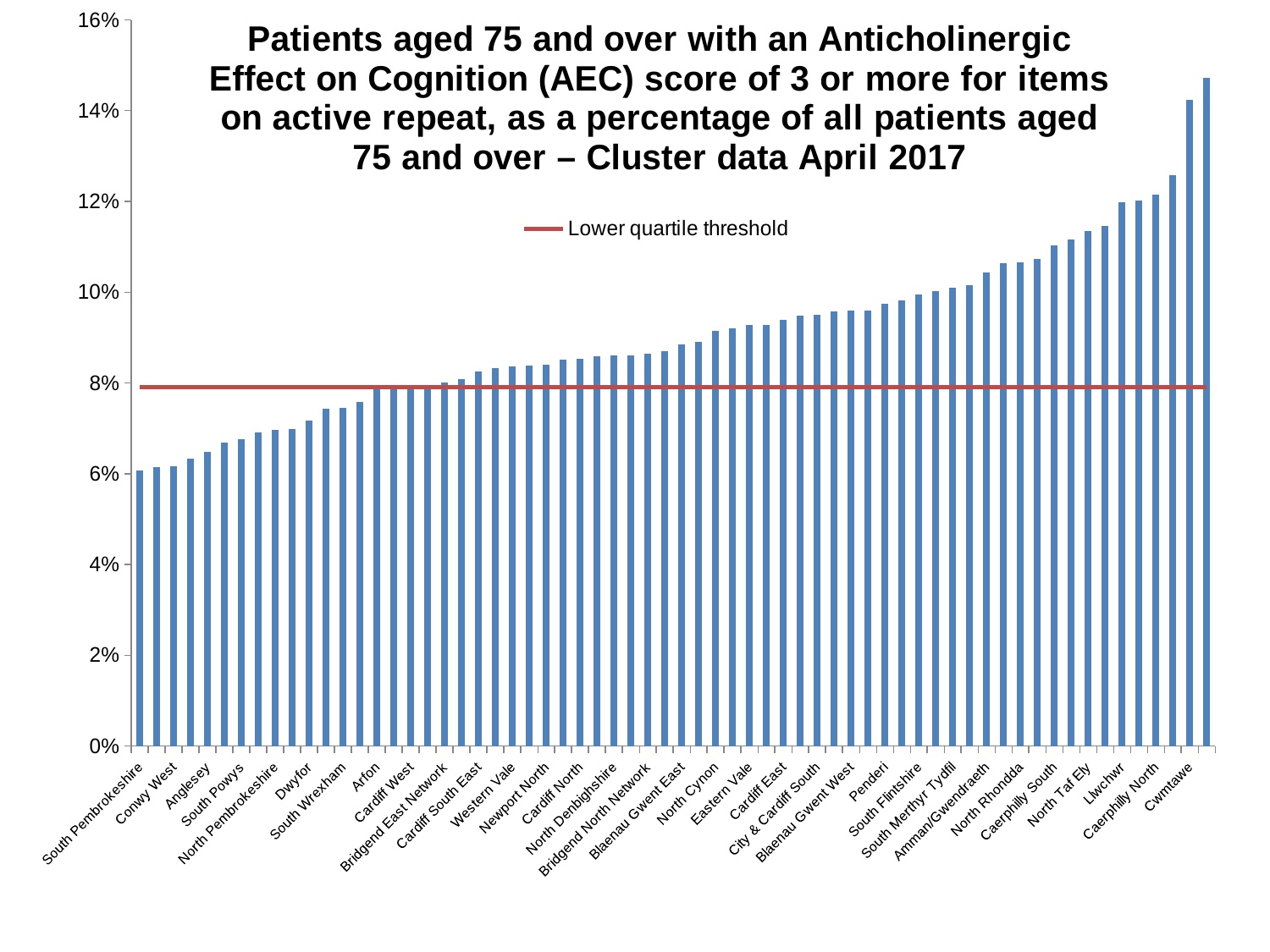
Is the value for North Taf Ely greater or less than 10%? greater Which has the larger value, Cwmtawe or South Pembrokeshire? Cwmtawe Is the value for South Pembrokeshire greater or less than 8%? less Which has the larger value, Penderi or Anglesey? Penderi Is the value for Cwmtawe greater or less than 12%? greater How many entries does the legend list? 1 Which labelled cluster has the lowest value? South Pembrokeshire Do the bar values rise or fall from left to right along the x axis? Rise What is the name of the line series shown in the legend? Lower quartile threshold What kind of chart is shown on the slide? Bar chart